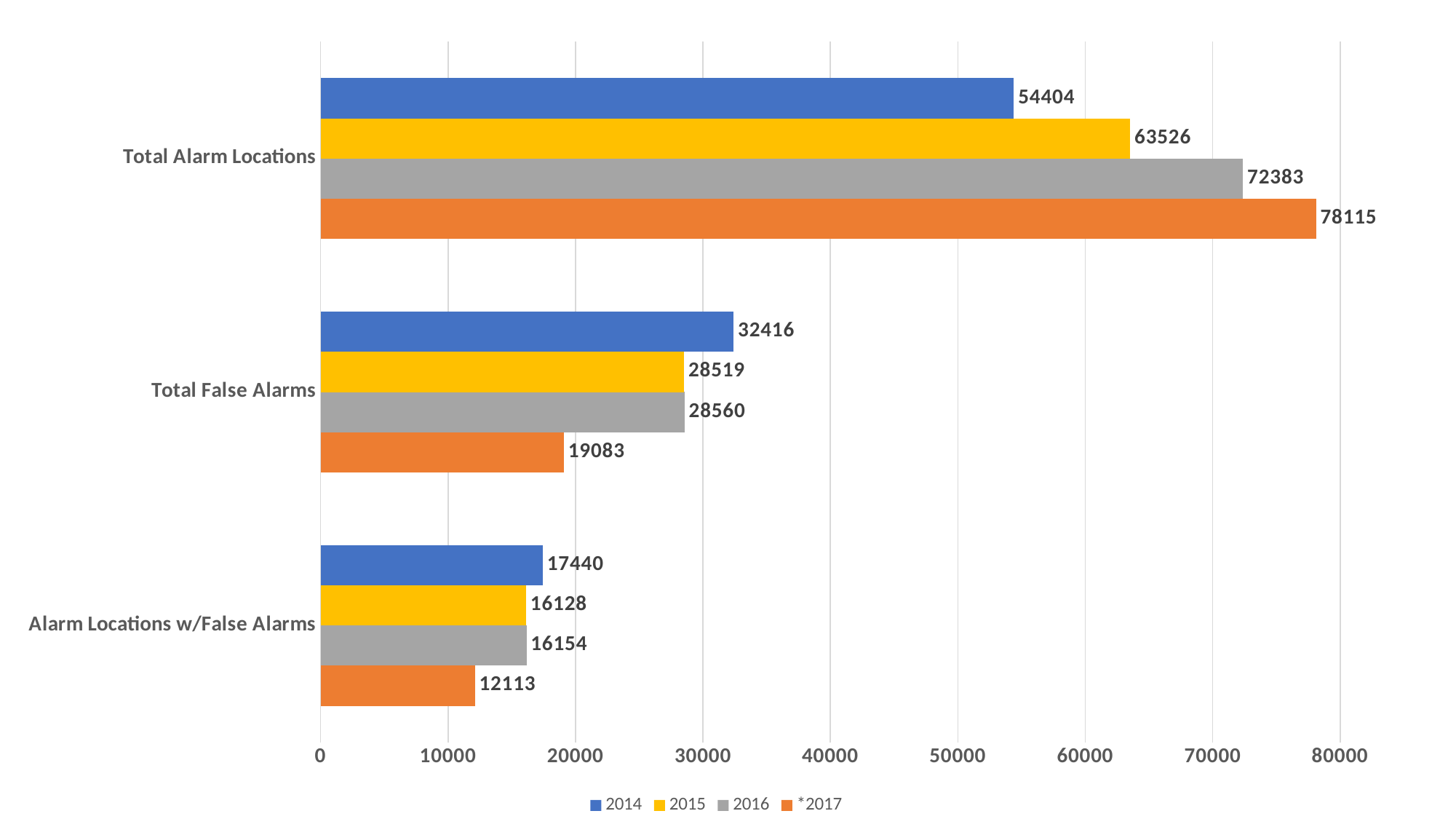
Which is larger: Total False Alarms in 2014 or Total False Alarms in 2016? 2014 What is the value for Total False Alarms in *2017? 19083 What kind of chart is shown on the slide? bar chart What is the value for Total Alarm Locations in 2016? 72383 What is the difference between the Total Alarm Locations values for *2017 and 2014? 23711 What is the value for Alarm Locations w/False Alarms in 2014? 17440 Is the value for Total Alarm Locations in 2015 greater or less than 60000? greater What colour are the bars for the 2016 series? grey Which year has the lowest value for Alarm Locations w/False Alarms? *2017 How many categories are shown on the chart? 3 How many series does the legend list? 4 Which year has the highest value for Total Alarm Locations? *2017